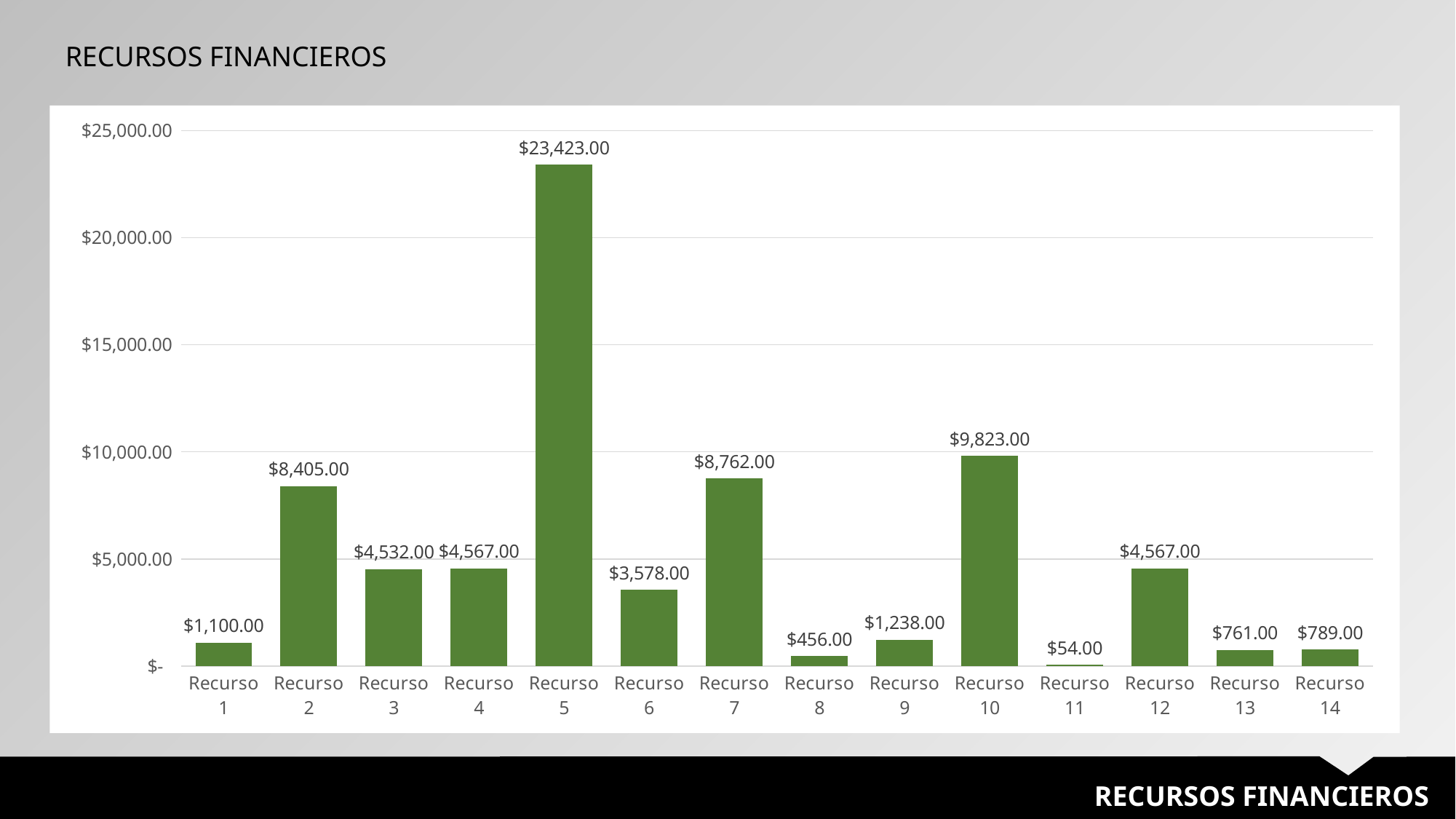
What is the title of the slide? RECURSOS FINANCIEROS What is the value for Recurso 11? $54.00 What kind of chart is shown on the slide? bar chart How many categories are shown on the x axis? 14 What is the difference between the values for Recurso 7 and Recurso 2? $357.00 What is the value for Recurso 10? $9,823.00 What is the difference between the values for Recurso 5 and Recurso 10? $13,600.00 Which category has the lowest value? Recurso 11 What is the value for Recurso 5? $23,423.00 Which is larger, the value for Recurso 13 or Recurso 14? Recurso 14 Is the value for Recurso 10 greater or less than $10,000.00? less Which category has the highest value? Recurso 5